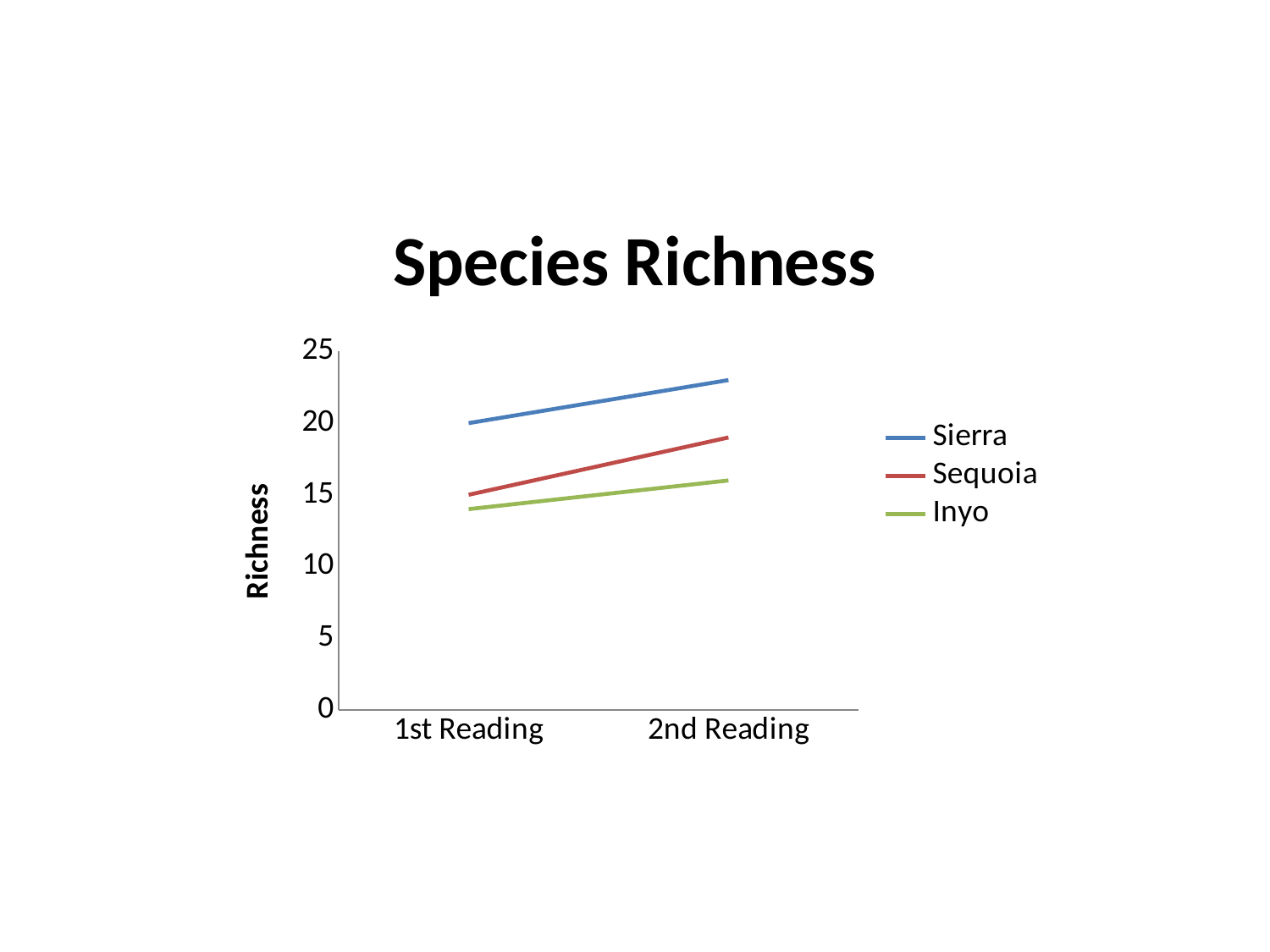
How many series does the legend list? 3 Is the value for Sequoia at 1st Reading greater or less than 20? less Is the value for Sierra at 2nd Reading greater or less than 20? greater What kind of chart is shown on the slide? line chart Which is larger at 1st Reading, Sierra or Sequoia? Sierra How many categories are shown on the x axis? 2 Which series has the lowest value at 1st Reading? Inyo Is the value for Inyo at 2nd Reading greater or less than 20? less What is the label on the y axis? Richness Which series has the highest value at 2nd Reading? Sierra What is the title of the chart? Species Richness Does the Sequoia line rise or fall from 1st Reading to 2nd Reading? rise